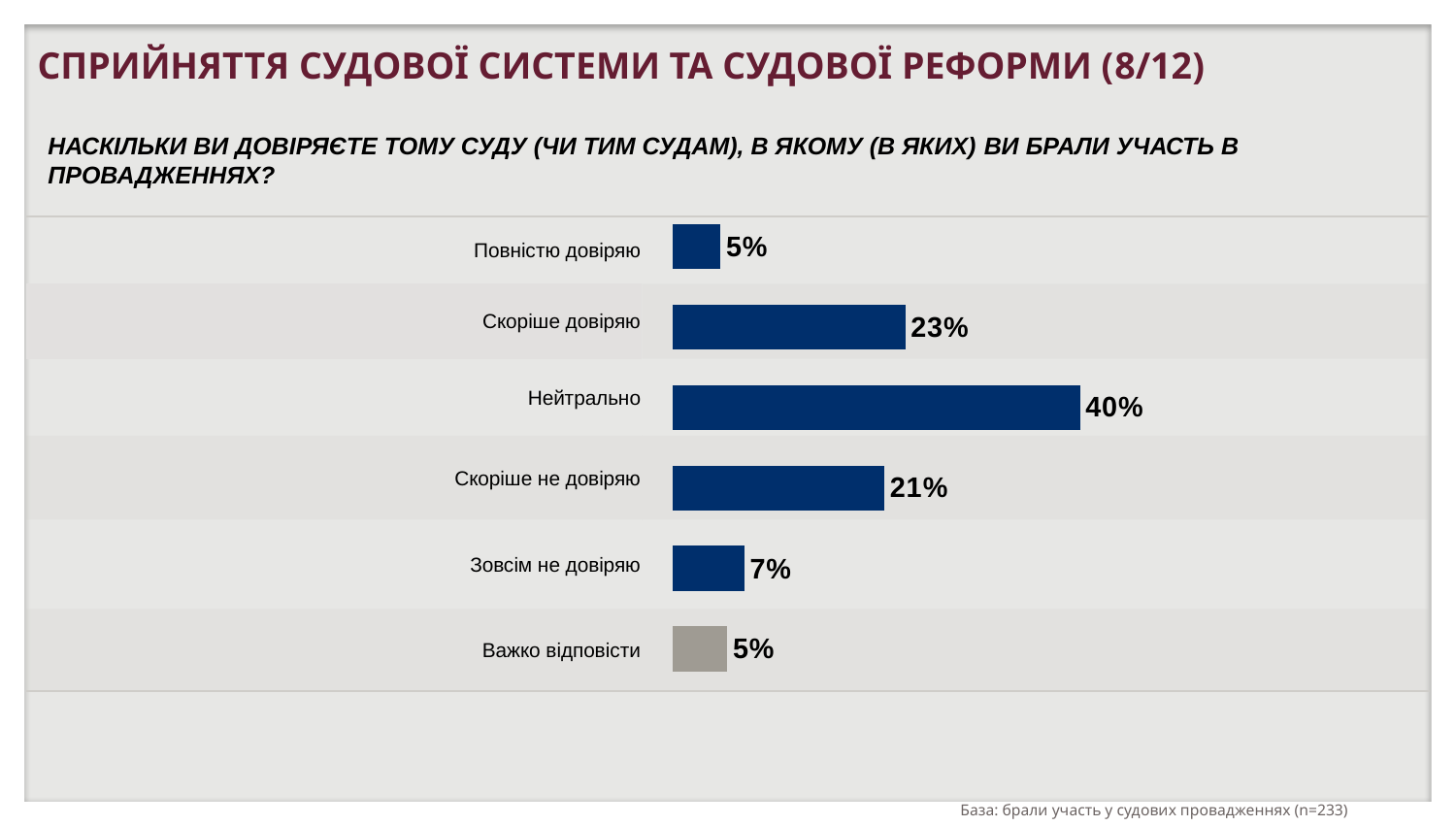
What is the difference between the values for "Скоріше довіряю" and "Скоріше не довіряю"? 2% Which category's bar is shown in grey rather than blue? Важко відповісти What is the value for "Зовсім не довіряю"? 7% What kind of chart is shown on the slide? Bar chart Which category has the highest value? Нейтрально What is the difference between the values for "Нейтрально" and "Повністю довіряю"? 35% What is the value for "Скоріше не довіряю"? 21% What is the value for "Скоріше довіряю"? 23% What is the value for "Нейтрально"? 40% How many categories are shown in the chart? 6 Which is larger, the value for "Зовсім не довіряю" or the value for "Повністю довіряю"? Зовсім не довіряю What is the sample size (n) stated in the base note at the bottom of the slide? 233